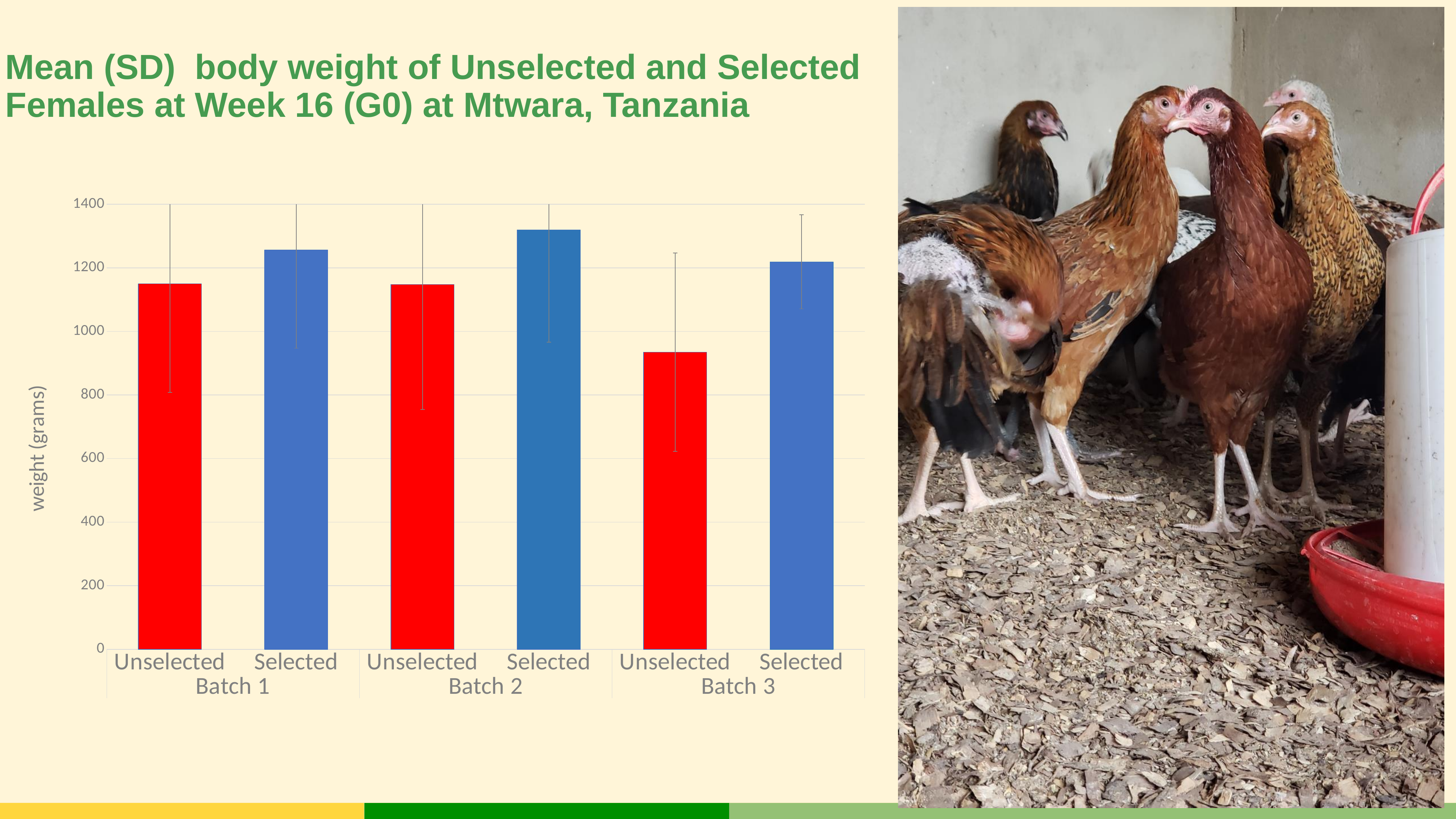
What colour are the Unselected bars in the chart? Red Is the value for Unselected in Batch 3 greater or less than 1000? less Which bar has the lowest value in the chart? Unselected, Batch 3 In Batch 1, which is larger, the Unselected or the Selected bar? Selected Which is larger, the Selected bar for Batch 2 or the Selected bar for Batch 1? Selected, Batch 2 How many batches are shown on the x axis of the chart? 3 What is the label of the y axis of the chart? weight (grams) Is the value for Selected in Batch 2 greater or less than 1200? greater Is the value for Unselected in Batch 1 greater or less than 1000? greater What kind of chart is shown on the slide? Bar chart How many bars are plotted in the chart? 6 Which bar has the highest value in the chart? Selected, Batch 2